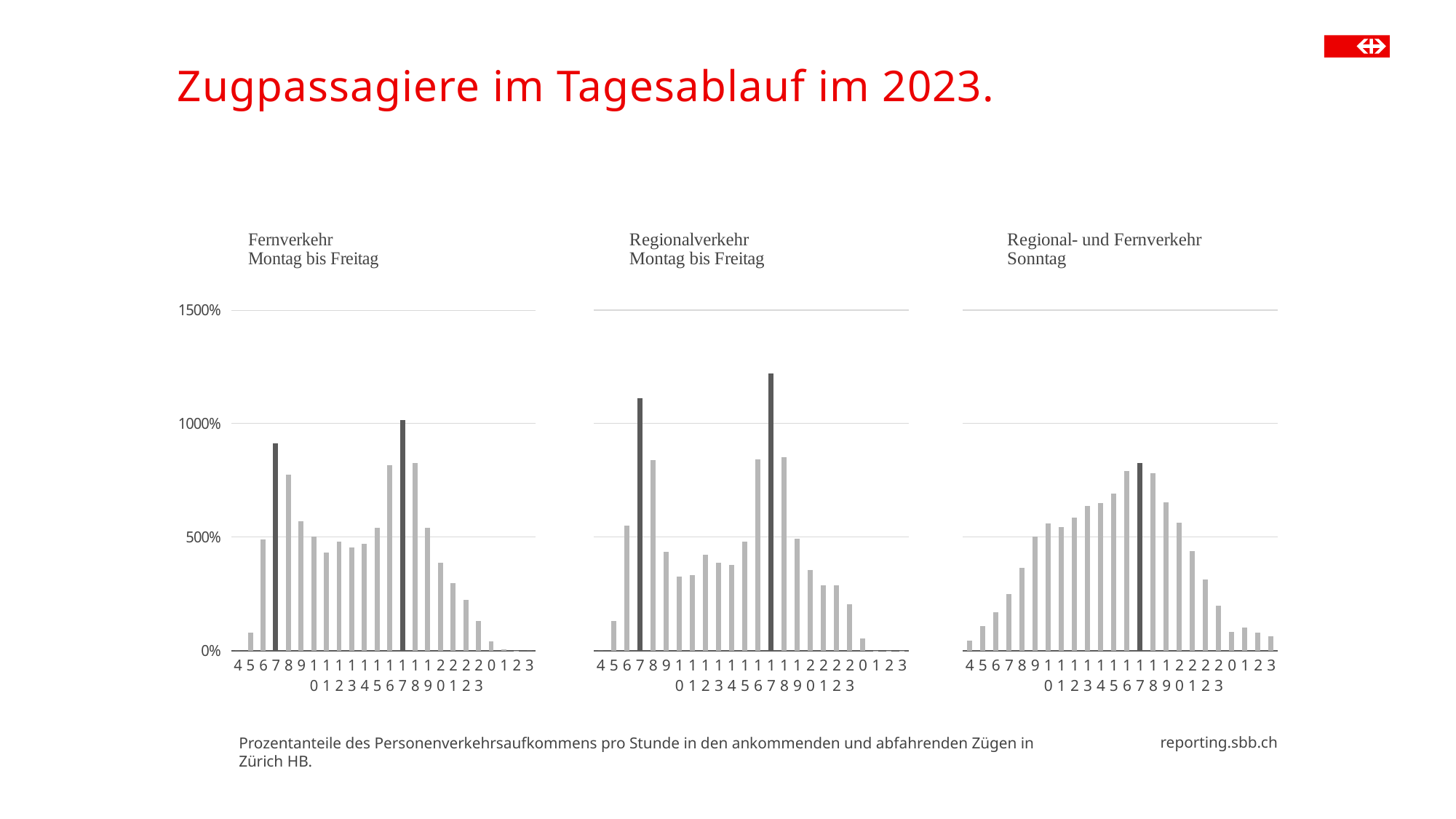
In the 'Regional- und Fernverkehr Sonntag' chart, is the value for hour 17 greater or less than 1000%? less In the 'Regional- und Fernverkehr Sonntag' chart, which hour has the highest value? 17 Which two hours are highlighted with dark bars in each of the three charts? 7 and 17 In the 'Fernverkehr Montag bis Freitag' chart, which hour has the highest value? 17 In the 'Regionalverkehr Montag bis Freitag' chart, is the value for hour 17 greater or less than 1000%? greater In the 'Fernverkehr Montag bis Freitag' chart, is the value for hour 7 greater or less than 1000%? less How many hourly categories are shown on the x axis of the 'Regionalverkehr Montag bis Freitag' chart? 24 In the 'Fernverkehr Montag bis Freitag' chart, which is larger, the value for hour 7 or the value for hour 8? hour 7 In the 'Regionalverkehr Montag bis Freitag' chart, which hour has the highest value? 17 In the 'Regional- und Fernverkehr Sonntag' chart, do the values rise or fall from hour 4 to hour 17? rise What kind of chart is the 'Fernverkehr Montag bis Freitag' chart? bar chart